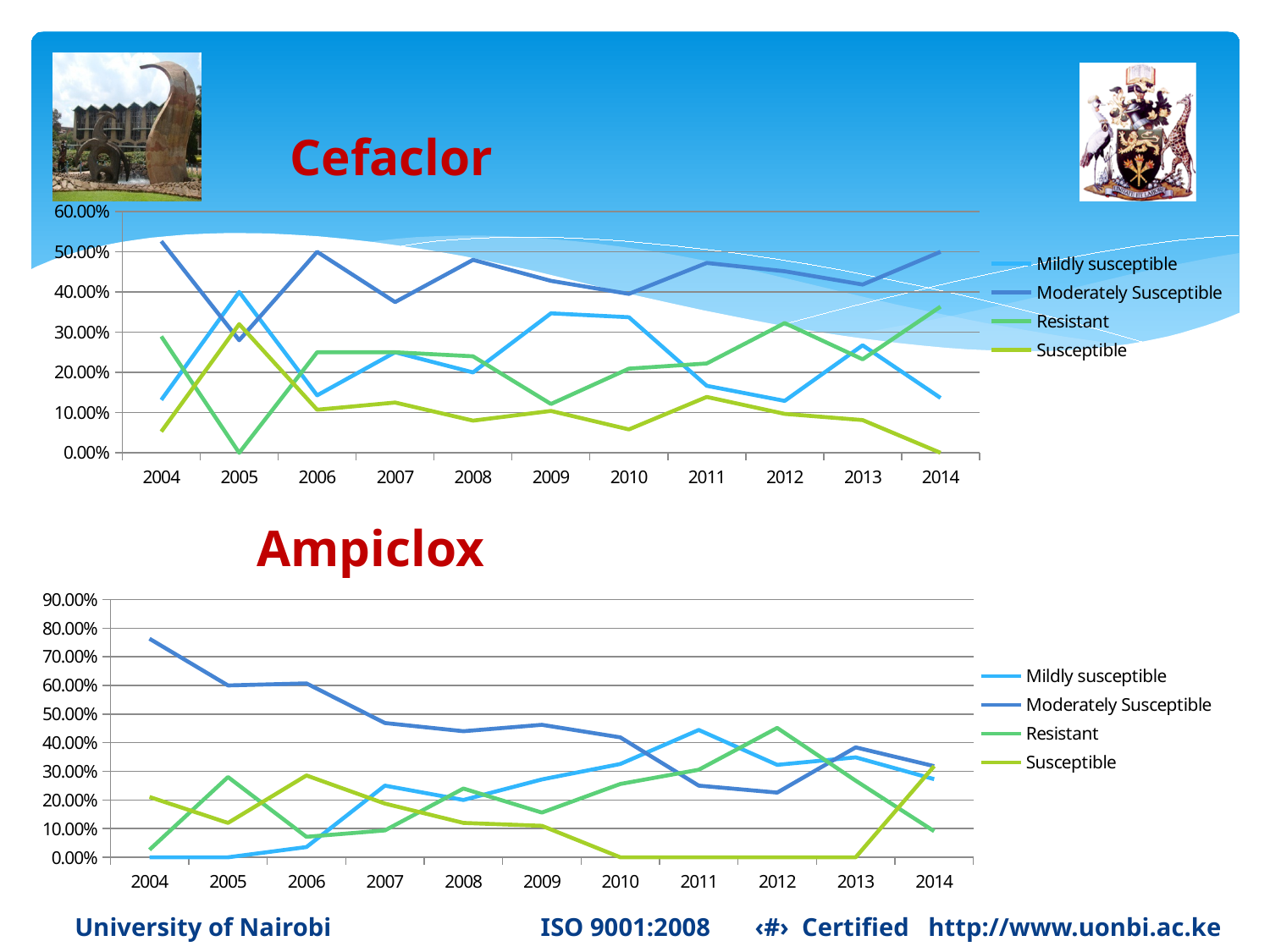
In the Ampiclox chart, what is the Mildly susceptible value in 2004? 0.00% How many years are shown on the x axis of the Cefaclor chart? 11 In the Cefaclor chart, in which year is the Resistant series lowest? 2005 How many series does the legend of the Ampiclox chart list? 4 In the Ampiclox chart, what is the Susceptible value in 2012? 0.00% In the Ampiclox chart, does the Moderately Susceptible series generally rise or fall from 2004 to 2014? fall In the Cefaclor chart, what is the Resistant value in 2005? 0.00% What type of chart is the Cefaclor chart? line chart In the Cefaclor chart, which is larger in 2014, Resistant or Mildly susceptible? Resistant In the Cefaclor chart, what is the Susceptible value in 2014? 0.00% In the Ampiclox chart, is the Moderately Susceptible value for 2004 greater or less than 70.00%? greater In the Ampiclox chart, in which year is the Moderately Susceptible series highest? 2004